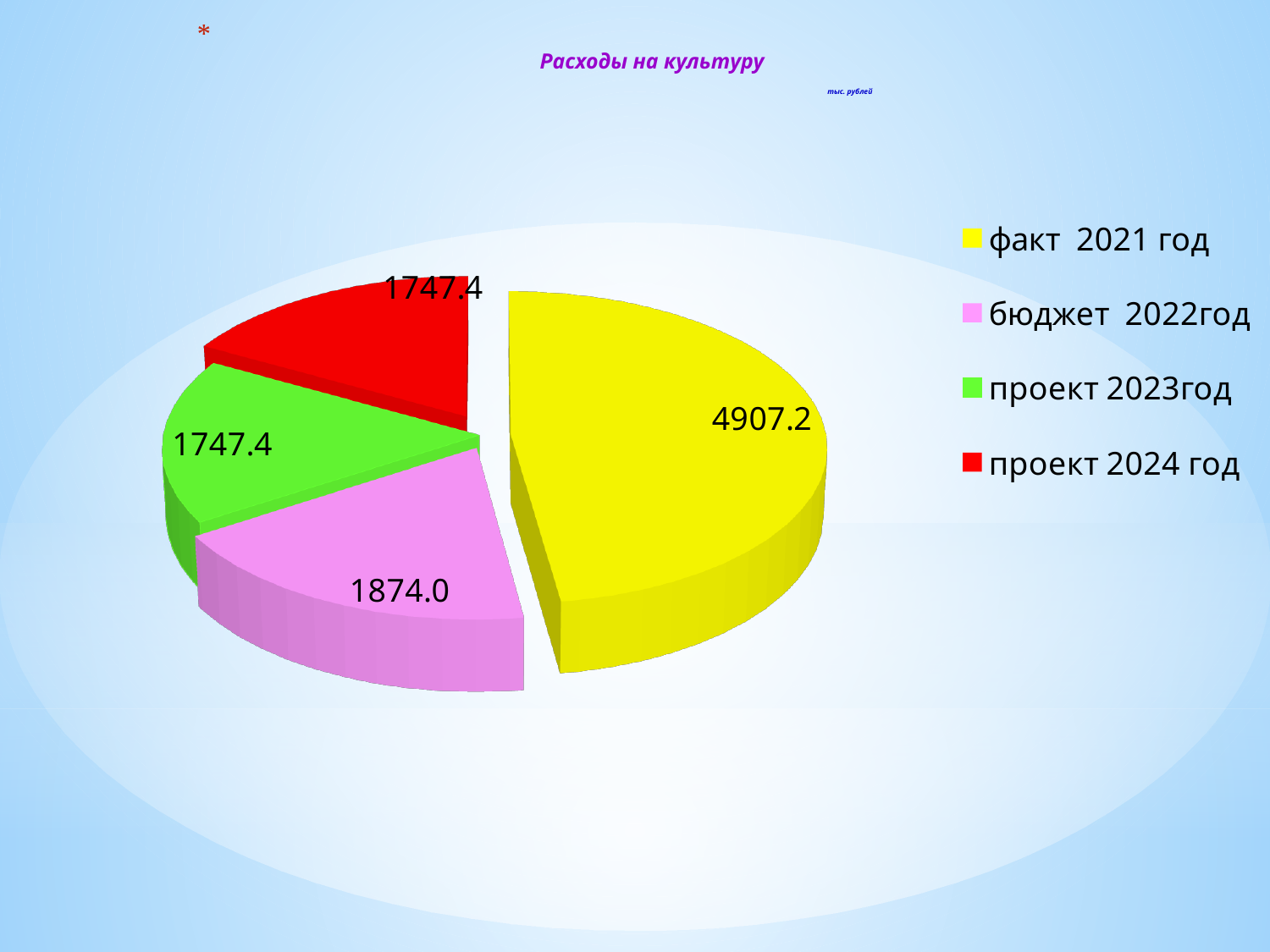
What is the value for проект 2024 год? 1747.4 What is the difference between the values for бюджет 2022год and проект 2023год? 126.6 What is the value for факт 2021 год? 4907.2 What is the value for бюджет 2022год? 1874.0 How many entries does the legend list? 4 What is the value for проект 2023год? 1747.4 How many slices does the pie chart have? 4 What is the difference between the values for факт 2021 год and бюджет 2022год? 3033.2 Which category has the largest slice of the pie? факт 2021 год What is the title of the chart? Расходы на культуру What kind of chart is shown on the slide? pie chart Which is larger, the value for бюджет 2022год or the value for проект 2024 год? бюджет 2022год